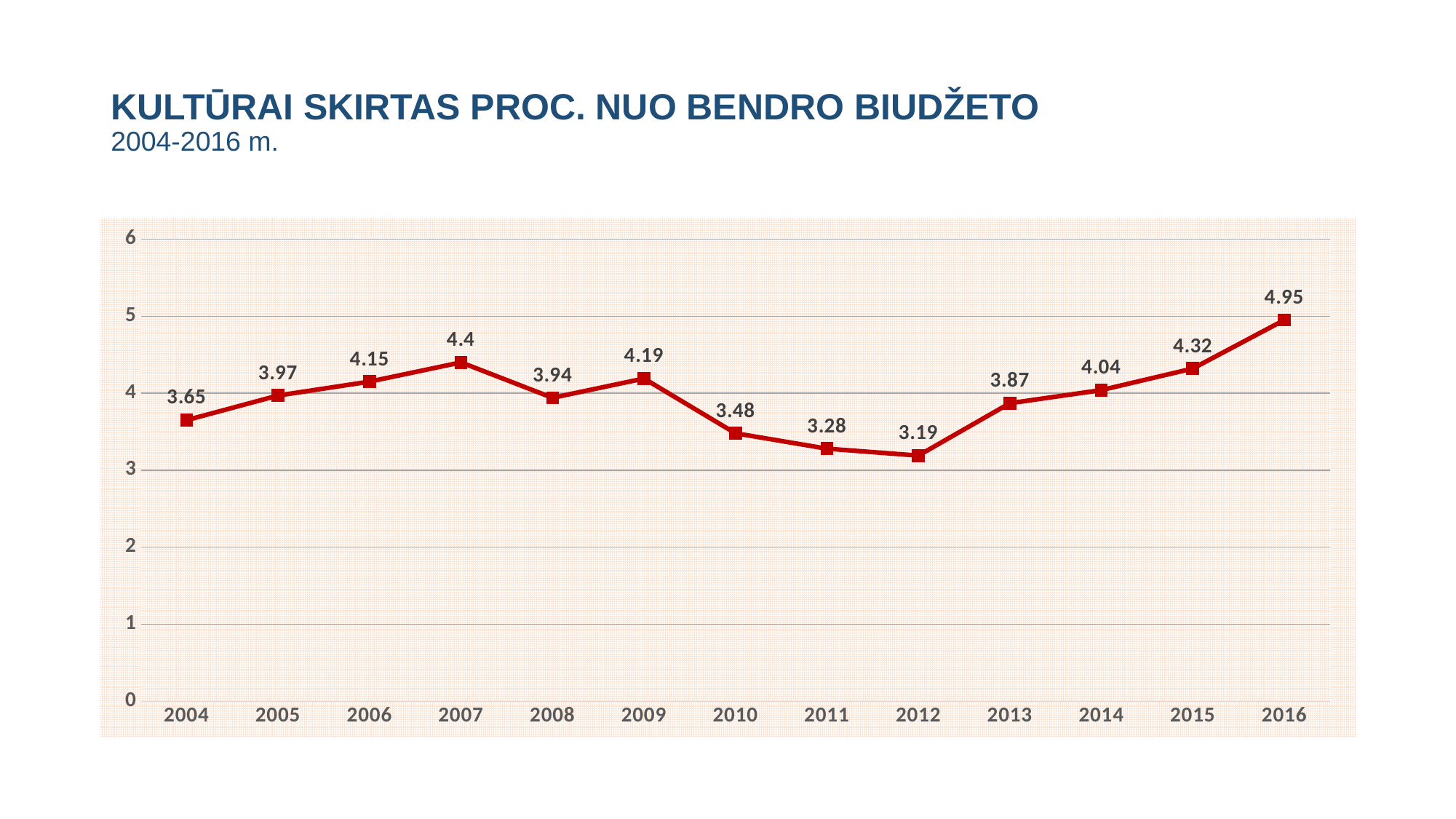
What is the title of the chart on the slide? KULTŪRAI SKIRTAS PROC. NUO BENDRO BIUDŽETO What is the value for 2012? 3.19 How many years are plotted on the chart? 13 Do the values rise or fall from 2012 to 2016? rise Which is larger, the value for 2007 or the value for 2009? 2007 Which year has the highest value? 2016 What is the value for 2004? 3.65 What kind of chart is shown on the slide? line chart Which year has the lowest value? 2012 What is the difference between the values for 2016 and 2012? 1.76 What is the value for 2016? 4.95 Is the value for 2011 greater or less than 4? less